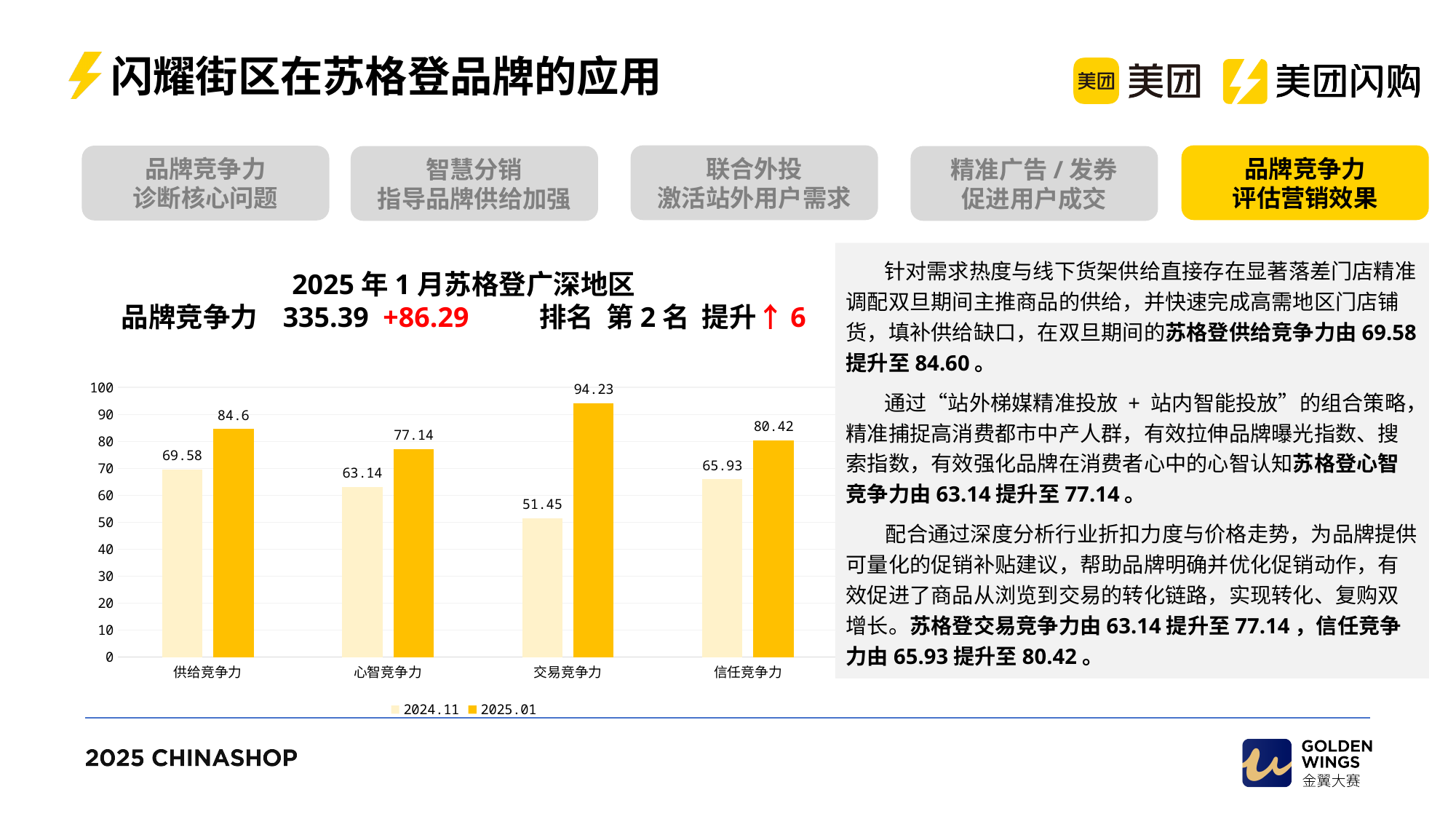
What kind of chart is shown on the slide? bar chart Which category has the highest 2025.01 value? 交易竞争力 How many categories are shown on the x axis of the chart? 4 What is the 2025.01 value for 供给竞争力? 84.6 Which is larger, the 2024.11 value for 供给竞争力 or the 2024.11 value for 信任竞争力? 供给竞争力 What is the 2025.01 value for 信任竞争力? 80.42 Is the 2025.01 value for 交易竞争力 greater or less than 90? greater What is the 2024.11 value for 交易竞争力? 51.45 Which category has the lowest 2024.11 value? 交易竞争力 What is the difference between the 2025.01 and 2024.11 values for 交易竞争力? 42.78 How many series does the chart legend list? 2 What is the difference between the 2025.01 and 2024.11 values for 心智竞争力? 14